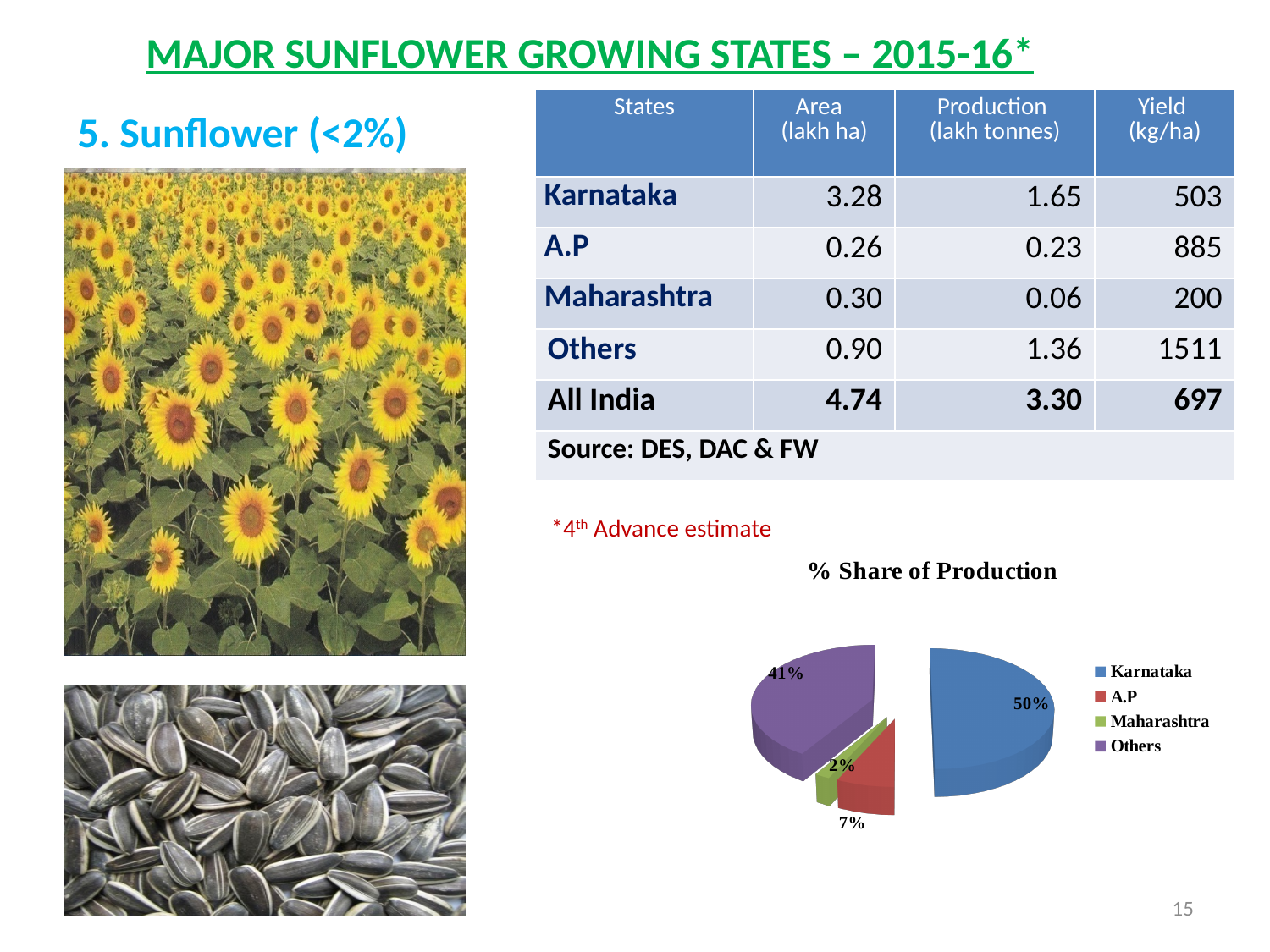
In the "% Share of Production" pie chart, what share does Others have? 41% What kind of chart is shown under the title "% Share of Production"? pie chart Which category has the smallest slice in the "% Share of Production" pie chart? Maharashtra How many categories does the legend of the "% Share of Production" pie chart list? 4 In the "% Share of Production" pie chart, which is larger, the share of A.P or the share of Maharashtra? A.P In the "% Share of Production" pie chart, what is the difference between the shares of Karnataka and Others? 9% Which category has the largest slice in the "% Share of Production" pie chart? Karnataka In the "% Share of Production" pie chart, what share does A.P have? 7% In the "% Share of Production" pie chart, what share does Karnataka have? 50% What is the title of the pie chart on the slide? % Share of Production In the "% Share of Production" pie chart, what share does Maharashtra have? 2% In the "% Share of Production" pie chart, what colour is the Karnataka slice? blue